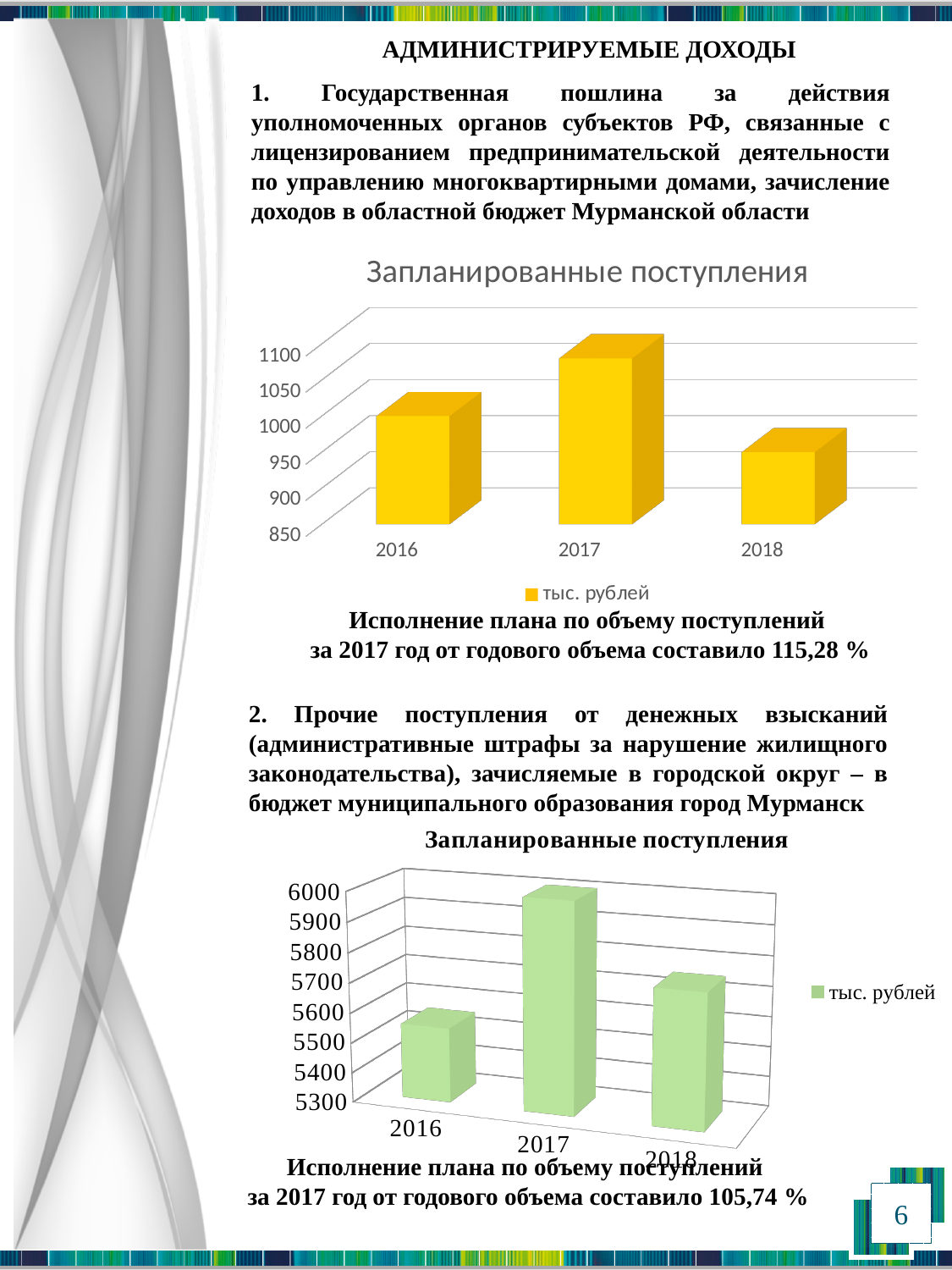
In the bottom chart, which year has the highest planned receipts? 2017 How many series does the legend of the bottom chart list? 1 In the top chart, which year has the lowest planned receipts? 2018 In the top chart, is the value for 2018 greater or less than 1000? less In the top chart, which year has the highest planned receipts? 2017 In the bottom chart, is the value for 2016 greater or less than 5600? less In the top chart, does the value rise or fall from 2017 to 2018? fall In the bottom chart, which year has the lowest planned receipts? 2016 What kind of chart is the top chart on the slide? bar chart What unit does the legend of the top chart give for the series? тыс. рублей In the top chart, is the value for 2017 greater or less than 1050? greater How many years are shown on the x axis of the top chart? 3